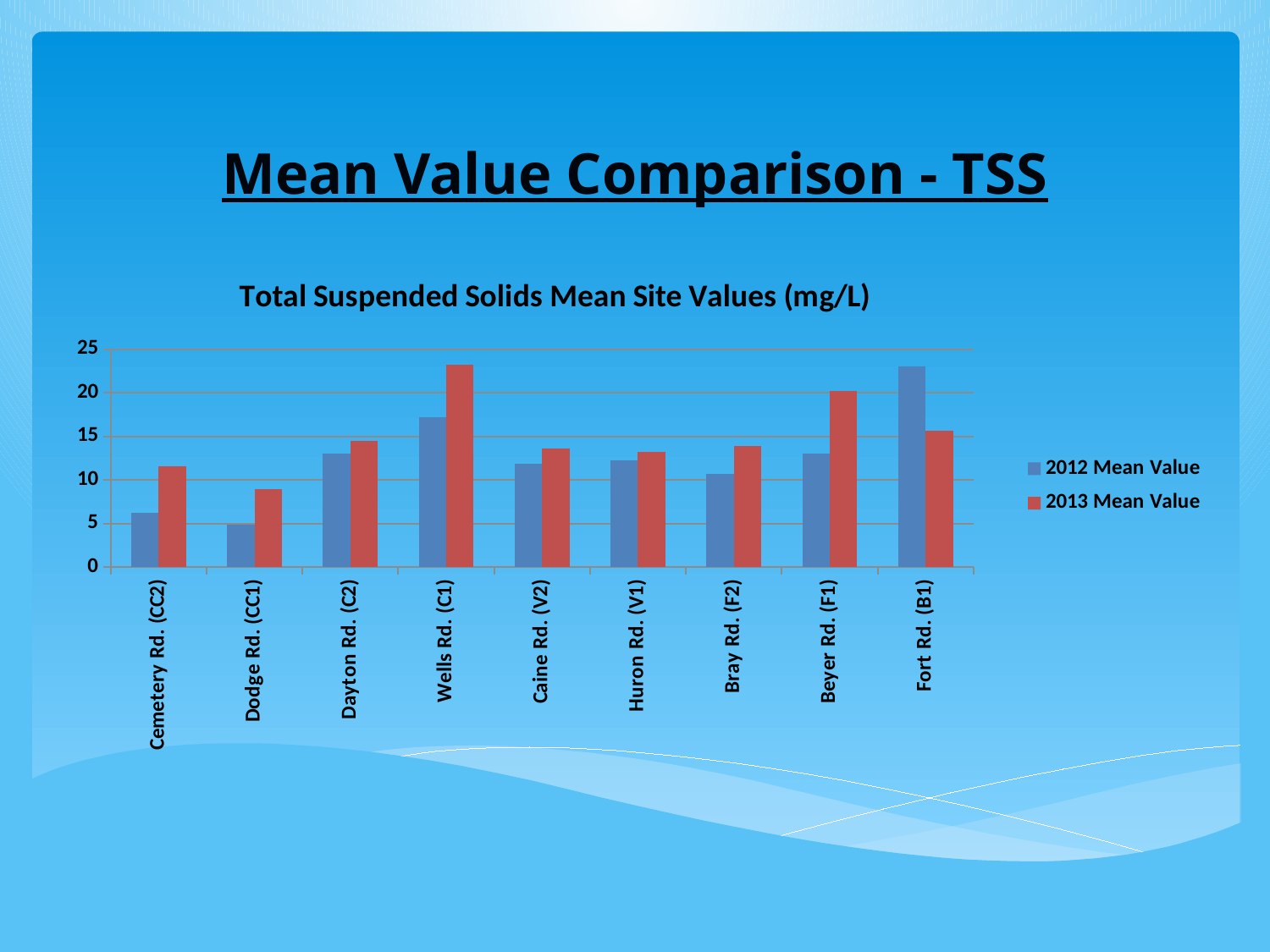
Which site has the lowest 2012 Mean Value? Dodge Rd. (CC1) Which site has the highest 2013 Mean Value? Wells Rd. (C1) What is the title of the chart? Total Suspended Solids Mean Site Values (mg/L) For Beyer Rd. (F1), which is larger: the 2012 Mean Value or the 2013 Mean Value? 2013 Mean Value Is the 2012 Mean Value for Dodge Rd. (CC1) greater or less than 10? less How many sites are shown along the x axis of the chart? 9 Which site has the lowest 2013 Mean Value? Dodge Rd. (CC1) What kind of chart is shown on the slide? Bar chart Is the 2013 Mean Value for Wells Rd. (C1) greater or less than 20? greater Which site has the highest 2012 Mean Value? Fort Rd. (B1) For Fort Rd. (B1), which is larger: the 2012 Mean Value or the 2013 Mean Value? 2012 Mean Value How many series does the chart's legend list? 2